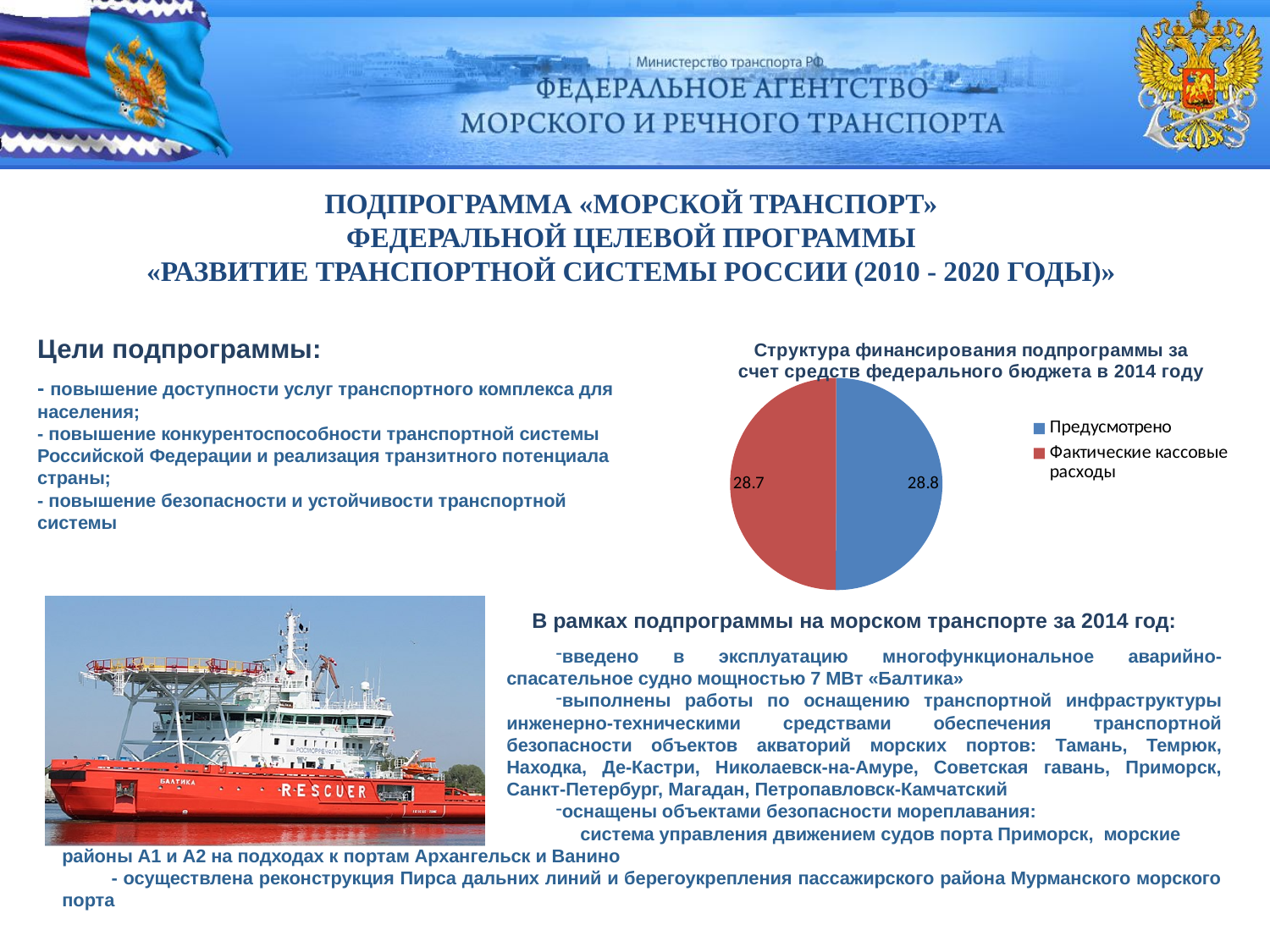
What is the difference between the values for "Предусмотрено" and "Фактические кассовые расходы" in the pie chart? 0.1 How many entries does the legend of the pie chart list? 2 Which year does the pie chart's title refer to? 2014 What is the value for "Предусмотрено" in the pie chart? 28.8 How many slices does the pie chart have? 2 What is the title of the pie chart? Структура финансирования подпрограммы за счет средств федерального бюджета в 2014 году What is the value for "Фактические кассовые расходы" in the pie chart? 28.7 According to the data labels, which slice has the larger value: "Предусмотрено" or "Фактические кассовые расходы"? Предусмотрено What kind of chart is shown on the slide? pie chart Which colour represents "Предусмотрено" in the pie chart? blue